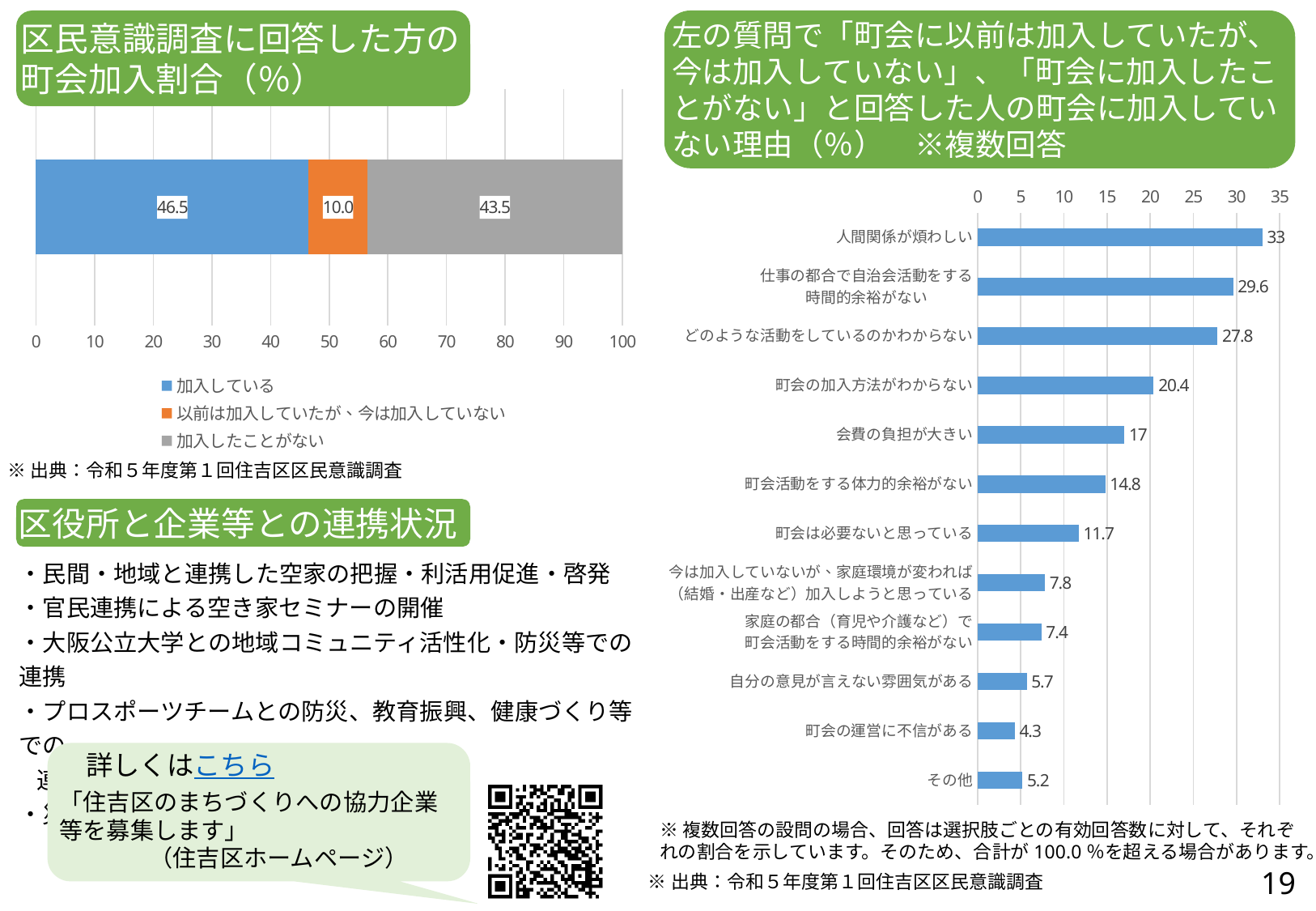
In the right chart (町会に加入していない理由), which category has the highest value? 人間関係が煩わしい In the left chart (区民意識調査に回答した方の町会加入割合), how many series does the legend list? 3 In the right chart (町会に加入していない理由), what is the difference between 会費の負担が大きい and 町会活動をする体力的余裕がない? 2.2 In the left chart (区民意識調査に回答した方の町会加入割合), what is the value for 加入したことがない? 43.5 In the right chart (町会に加入していない理由), what is the value for 人間関係が煩わしい? 33 In the right chart (町会に加入していない理由), which category has the lowest value? 町会の運営に不信がある What kind of chart is the right chart (町会に加入していない理由)? Bar chart In the left chart (区民意識調査に回答した方の町会加入割合), what is the total of the stacked bar? 100.0 In the left chart (区民意識調査に回答した方の町会加入割合), what colour is the segment for 以前は加入していたが、今は加入していない? Orange In the right chart (町会に加入していない理由), how many categories are plotted? 12 In the right chart (町会に加入していない理由), what is the value for 町会の加入方法がわからない? 20.4 In the left chart (区民意識調査に回答した方の町会加入割合), what is the value for 加入している? 46.5